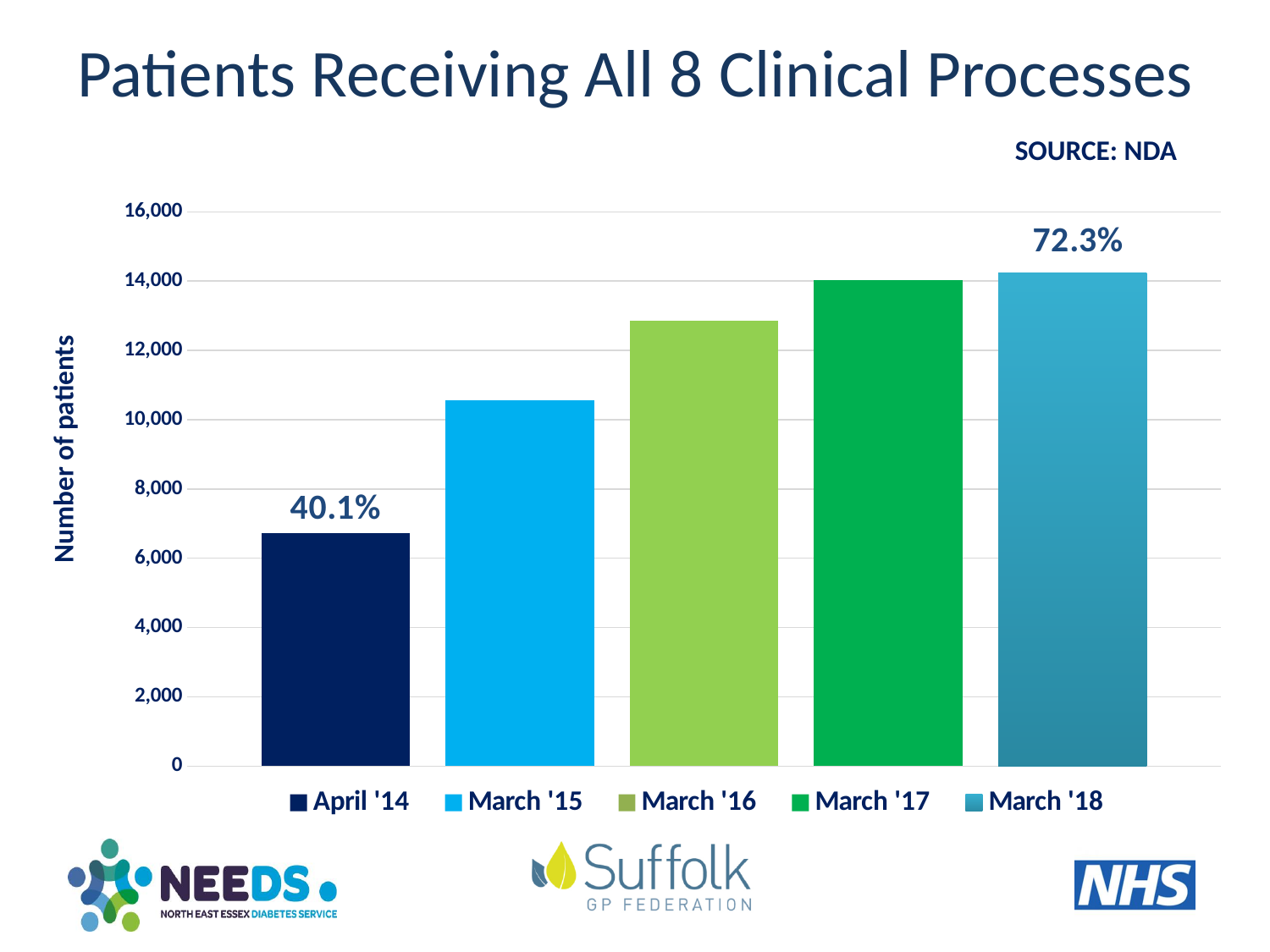
How many entries does the legend list? 5 Which is larger, the value for March '15 or the value for March '16? March '16 Is the value for April '14 greater or less than 8,000? less What kind of chart is shown on the slide? bar chart Do the values rise or fall from April '14 to March '18? rise Is the value for March '15 greater or less than 10,000? greater How many bars are plotted in the chart? 5 What percentage label is printed above the March '18 bar? 72.3% Is the value for March '16 greater or less than 14,000? less What percentage label is printed above the April '14 bar? 40.1% Which period has the lowest number of patients? April '14